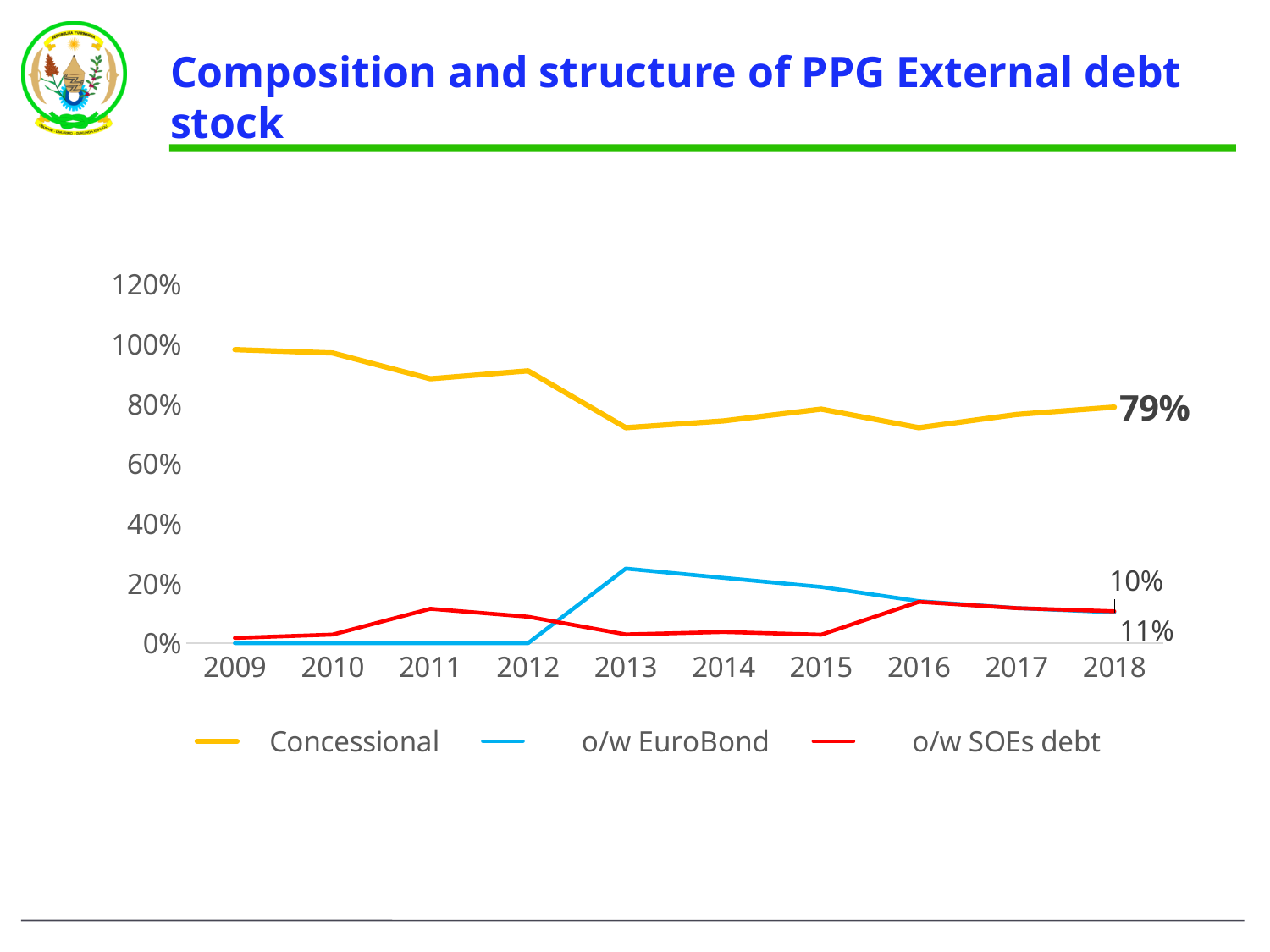
What is the value of the Concessional series in 2018? 79% Does the o/w EuroBond series rise or fall from 2013 to 2016? Fall In 2013, which is larger: o/w EuroBond or o/w SOEs debt? o/w EuroBond How many years are shown on the x axis? 10 Is the value for Concessional in 2009 greater or less than 80%? greater How many series does the legend list? 3 What colour is the Concessional line? Yellow Is the value for o/w SOEs debt in 2011 greater or less than 20%? less Is the value for Concessional in 2013 greater or less than 80%? less What kind of chart is shown on the slide? Line chart Does the Concessional series rise or fall from 2009 to 2013? Fall